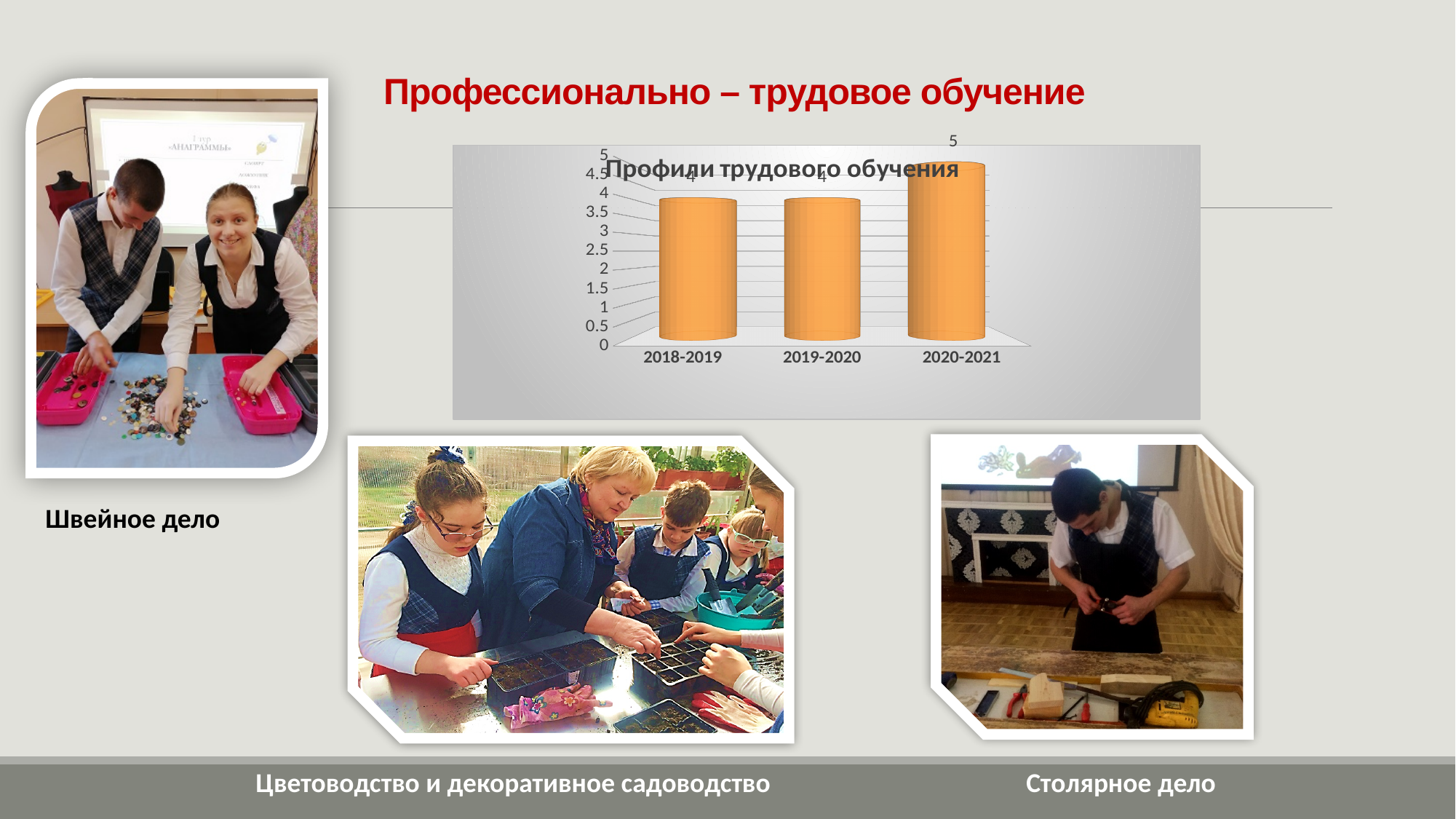
What is the title of the chart on the slide? Профили трудового обучения What is the value for 2020-2021 in the chart 'Профили трудового обучения'? 5 Is the value for 2020-2021 larger than the value for 2019-2020 in the chart? Yes What is the value for 2019-2020 in the chart 'Профили трудового обучения'? 4 What colour are the bars in the chart? Orange What kind of chart is shown on the slide? Bar chart Which year has the highest value in the chart 'Профили трудового обучения'? 2020-2021 How many categories are shown on the x axis of the chart? 3 Is the value for 2018-2019 greater or less than 4.5 in the chart? less What is the difference between the values for 2020-2021 and 2018-2019 in the chart? 1 Do the values in the chart rise or fall from 2018-2019 to 2020-2021? Rise What is the value for 2018-2019 in the chart 'Профили трудового обучения'? 4